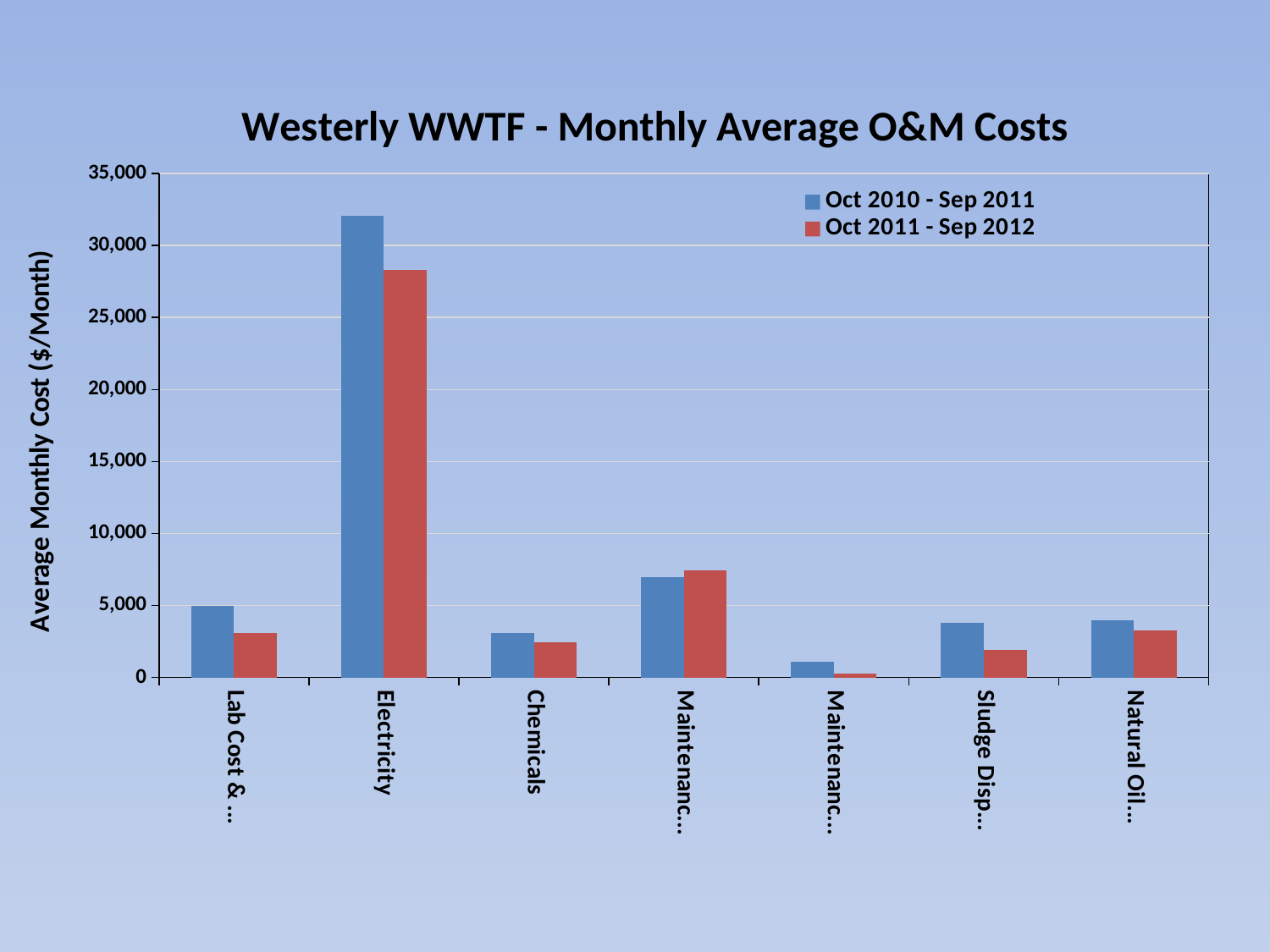
Is the value for Chemicals in Oct 2010 - Sep 2011 greater or less than 5,000? less What kind of chart is shown on the slide? bar chart For Chemicals, which series has the larger value: Oct 2010 - Sep 2011 or Oct 2011 - Sep 2012? Oct 2010 - Sep 2011 For Electricity, which series has the larger value: Oct 2010 - Sep 2011 or Oct 2011 - Sep 2012? Oct 2010 - Sep 2011 What is the title of the chart? Westerly WWTF - Monthly Average O&M Costs Is the value for Electricity in Oct 2011 - Sep 2012 greater or less than 30,000? less Is the value for Electricity in Oct 2010 - Sep 2011 greater or less than 30,000? greater Which category has the highest value for Oct 2010 - Sep 2011? Electricity How many series does the legend list? 2 What is the label on the vertical axis? Average Monthly Cost ($/Month) How many categories are plotted along the x axis? 7 For Oct 2011 - Sep 2012, which is larger: Electricity or Chemicals? Electricity